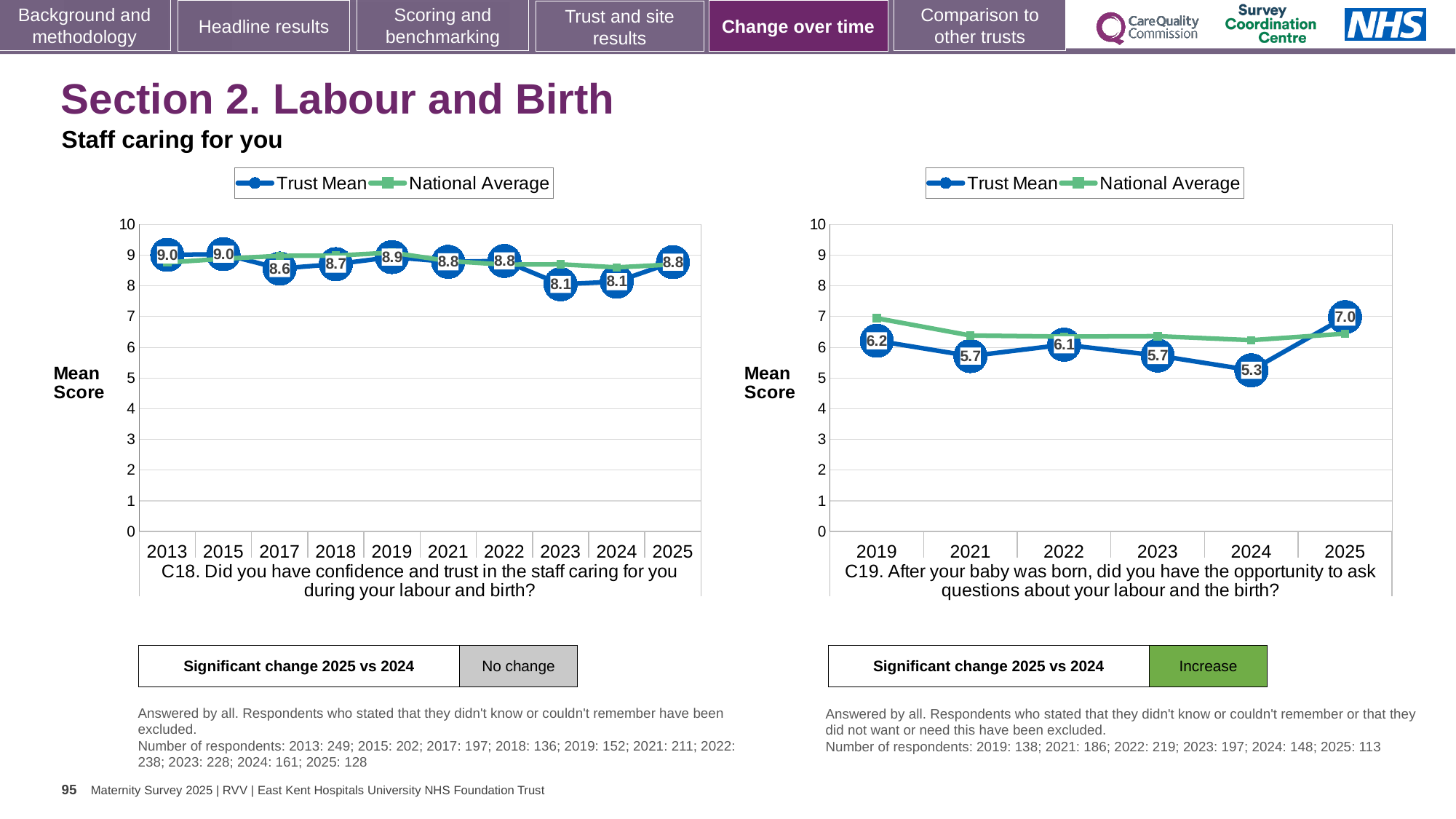
In the C19 chart (right), what is the Trust Mean for 2024? 5.3 In the C19 chart (right), which year has the highest Trust Mean? 2025 How many years are plotted on the x axis of the C18 chart (left)? 10 In the C18 chart (left), what is the Trust Mean for 2025? 8.8 In the C18 chart (left), what is the Trust Mean for 2023? 8.1 In the C18 chart (left), is the Trust Mean higher in 2019 or in 2023? 2019 In the C19 chart (right), does the Trust Mean rise or fall from 2024 to 2025? Rise What type of chart is the C18 chart (left)? Line chart In the C19 chart (right), which year has the lowest Trust Mean? 2024 How many series does the legend of the C19 chart (right) list? 2 In the C19 chart (right), is the National Average for 2019 greater or less than 6? greater In the C19 chart (right), what is the difference between the Trust Mean for 2025 and 2024? 1.7